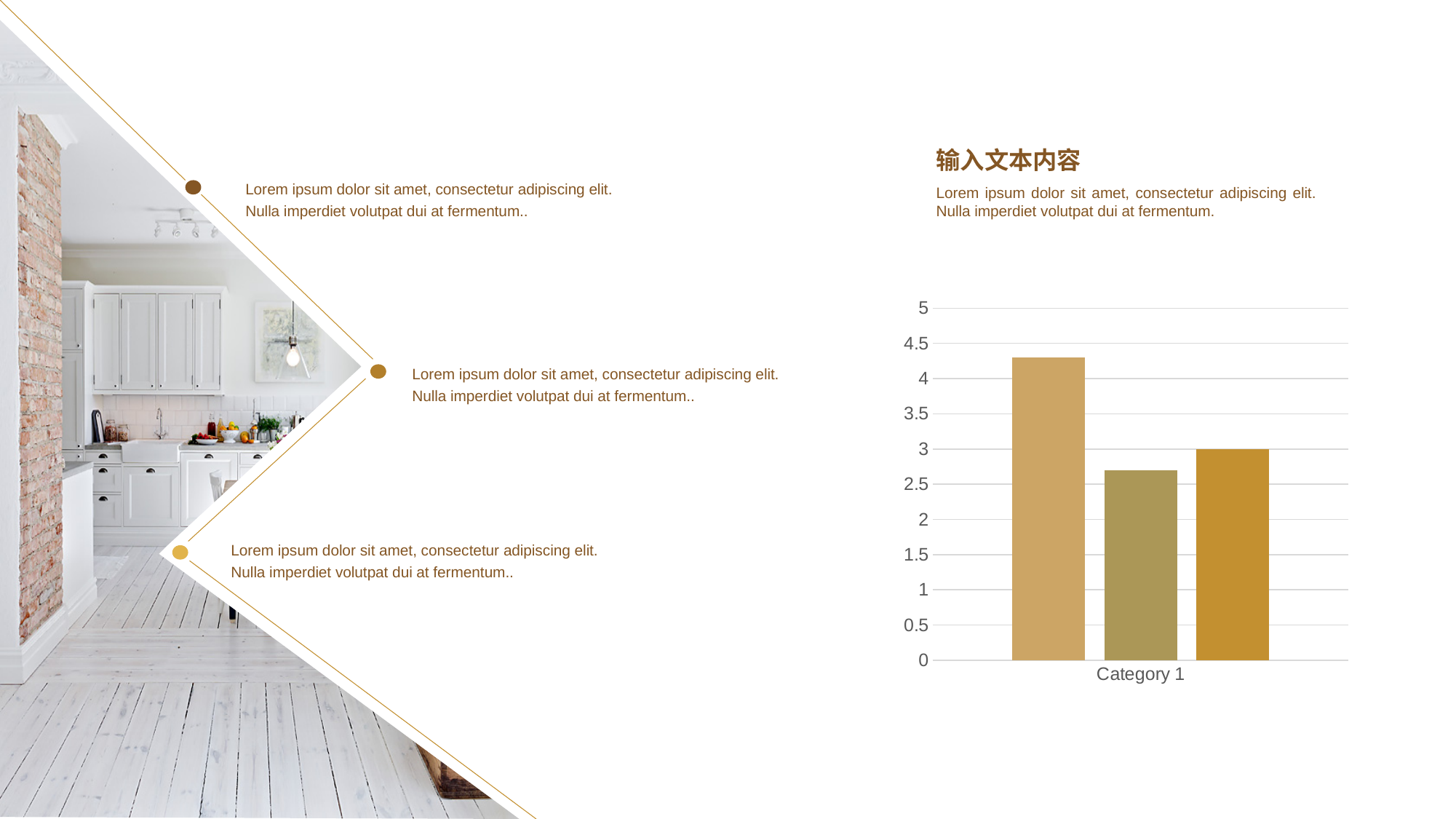
Which bar in the chart is the shortest? the middle bar How many categories are shown on the x axis of the chart? 1 Is the value of the middle bar greater or less than 2? greater What is the highest value shown on the y axis of the chart? 5 Is the value of the middle bar greater or less than 3? less How many bars are plotted in the chart? 3 What is the label of the category on the x axis? Category 1 Which is larger, the leftmost bar or the rightmost bar? the leftmost bar Which bar in the chart is the tallest? the leftmost bar What kind of chart is shown on the slide? bar chart Is the value of the rightmost bar greater or less than 2.5? greater